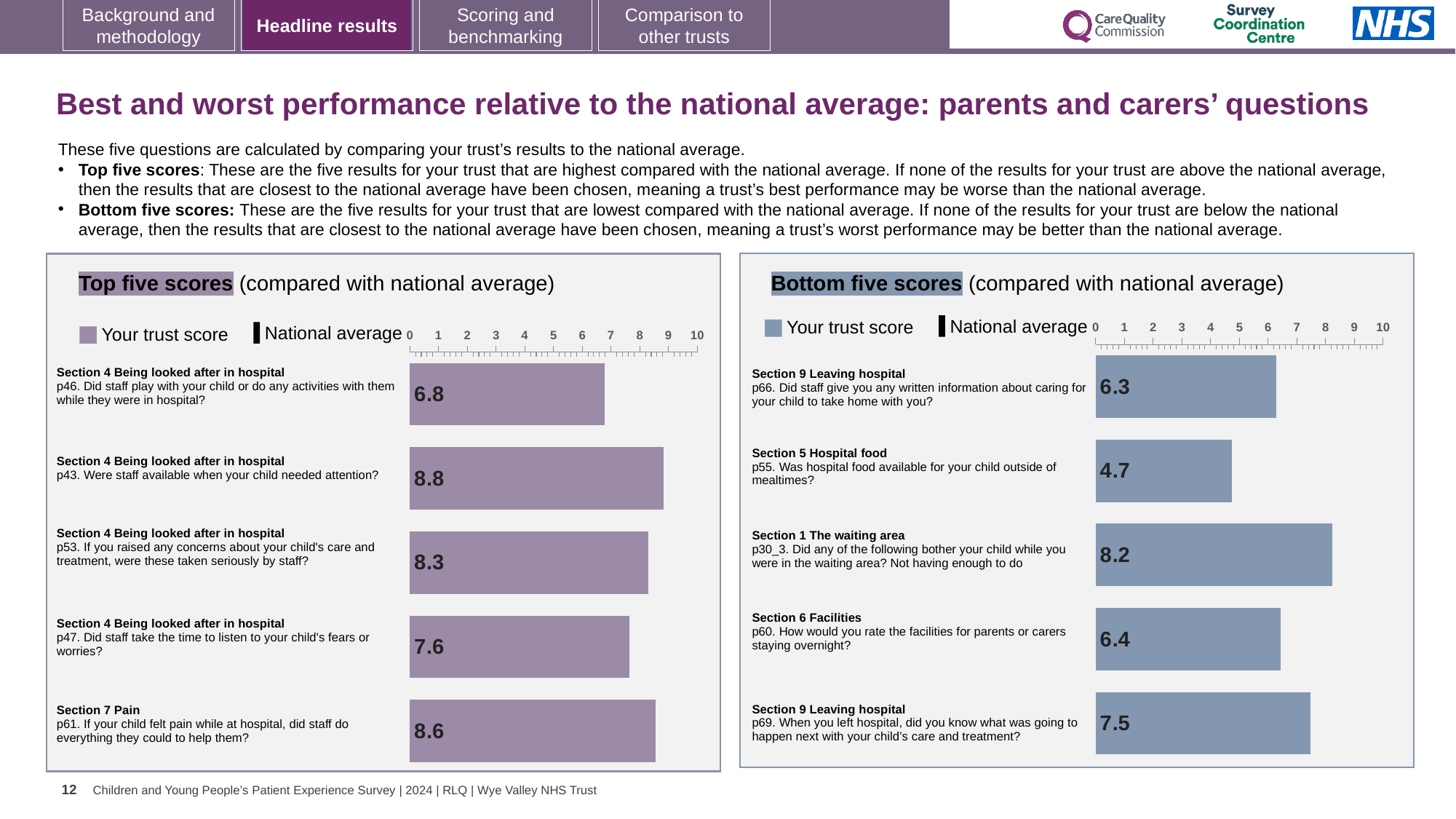
On the Top five scores chart, what is the difference between the trust scores for p43 and p46? 2.0 On the Top five scores chart, what is the trust score for p43 (Were staff available when your child needed attention?)? 8.8 On the Bottom five scores chart, what is the difference between the trust scores for p30_3 and p55? 3.5 On the Bottom five scores chart, what is the trust score for p55 (Was hospital food available for your child outside of mealtimes?)? 4.7 On the Bottom five scores chart, which question has the lowest trust score? p55. Was hospital food available for your child outside of mealtimes? On the Top five scores chart, what is the trust score for p61 (If your child felt pain while at hospital, did staff do everything they could to help them?)? 8.6 On the Bottom five scores chart, which has the higher trust score: p30_3 (Not having enough to do in the waiting area) or p69 (When you left hospital, did you know what was going to happen next)? p30_3 How many questions are shown on the Bottom five scores chart? 5 What kind of chart is the Top five scores chart? Bar chart On the Top five scores chart, which question has the lowest trust score? p46. Did staff play with your child or do any activities with them while they were in hospital? On the Top five scores chart, is the trust score for p47 (Did staff take the time to listen to your child's fears or worries?) greater or less than 7? greater On the Top five scores chart, which question has the highest trust score? p43. Were staff available when your child needed attention?